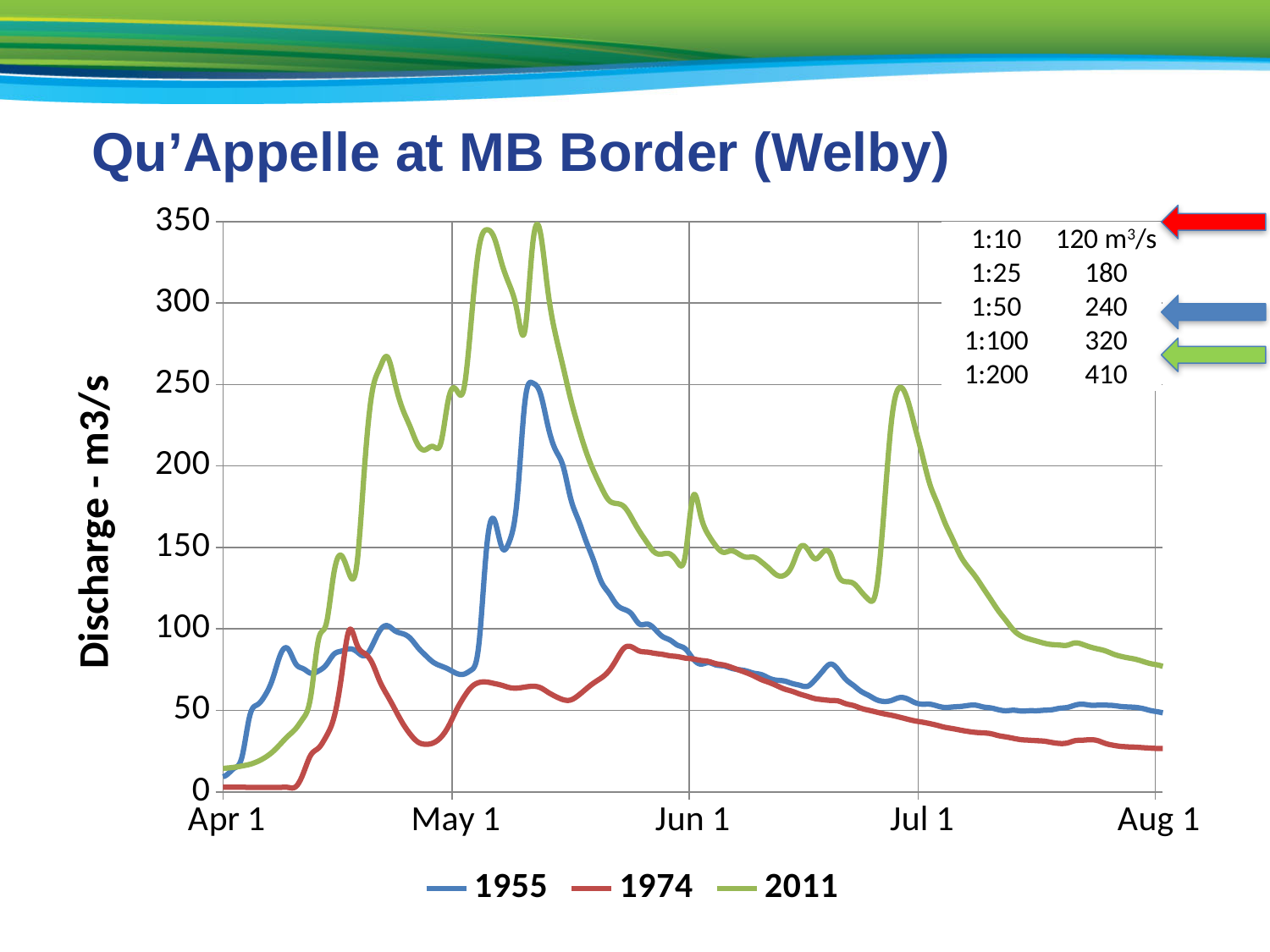
Does the 2011 series rise or fall between Jul 1 and Aug 1? Fall What is the label of the vertical axis? Discharge - m3/s Which series has the higher value on Jul 1, 1955 or 2011? 2011 Which series has the lowest peak discharge? 1974 Is the peak value of the 1974 series greater or less than 150? less Is the value of the 2011 series on Aug 1 greater or less than 50? greater Is the peak value of the 1955 series greater or less than 200? greater What is the title of the chart? Qu'Appelle at MB Border (Welby) Which series reaches the highest discharge on the chart? 2011 What kind of chart is shown on the slide? Line chart How many series does the legend list? 3